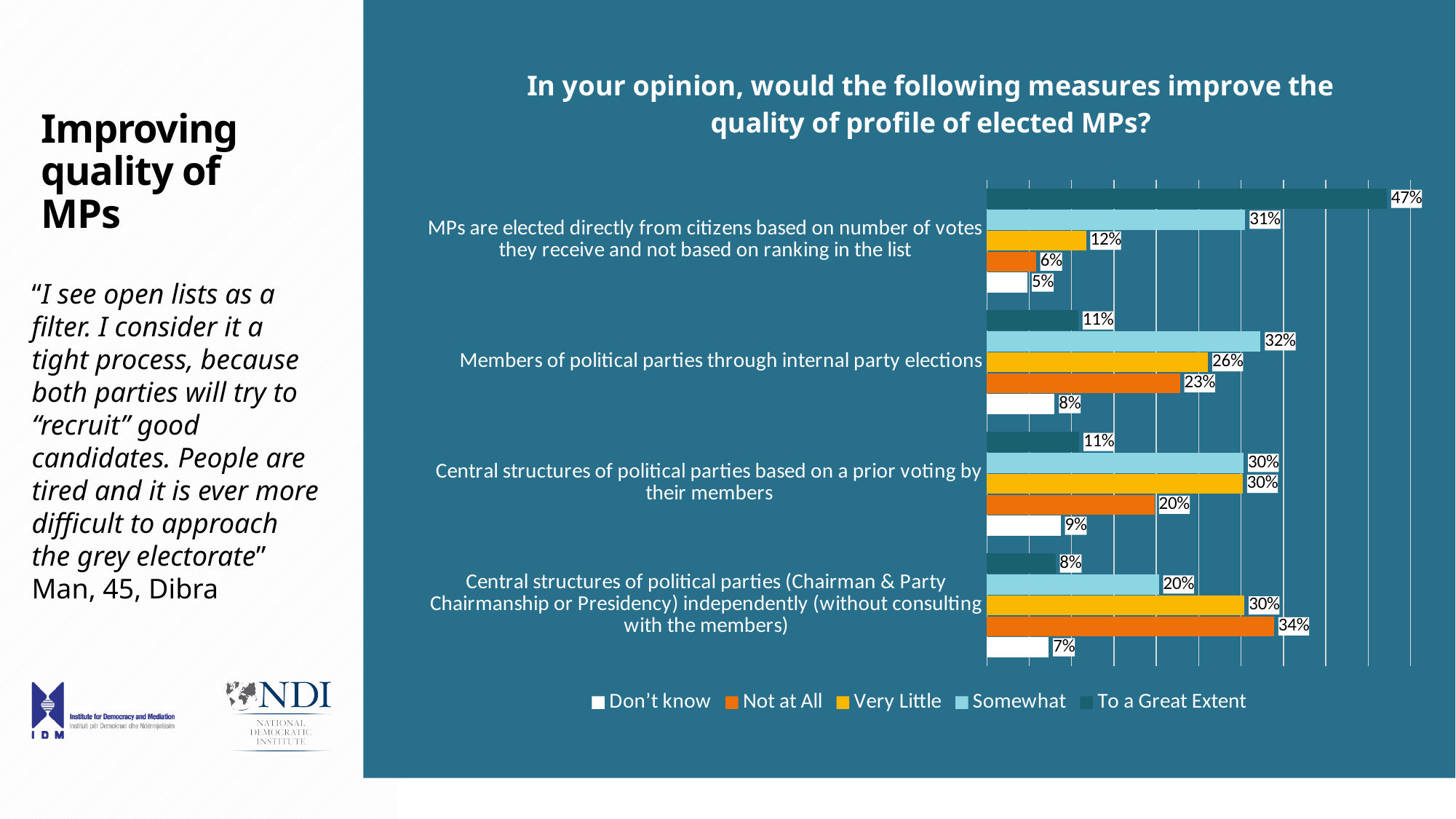
How many series does the legend list? 5 What is the 'Not at All' value for 'Central structures of political parties (Chairman & Party Chairmanship or Presidency) independently (without consulting with the members)'? 34% What is the 'Somewhat' value for 'Members of political parties through internal party elections'? 32% Which is larger: the 'Not at All' value for 'Members of political parties through internal party elections' or the 'Not at All' value for 'Central structures of political parties based on a prior voting by their members'? Members of political parties through internal party elections What percentage of respondents said 'To a Great Extent' for the measure 'MPs are elected directly from citizens based on number of votes they receive and not based on ranking in the list'? 47% How many measures (categories) are shown in the chart? 4 Which legend entry is shown in orange? Not at All What type of chart is shown on the slide? Bar chart What is the difference between the 'To a Great Extent' value for 'MPs are elected directly from citizens...' and the 'To a Great Extent' value for 'Members of political parties through internal party elections'? 36% What is the 'Don't know' value for 'Central structures of political parties based on a prior voting by their members'? 9% Which measure has the lowest 'Somewhat' value? Central structures of political parties (Chairman & Party Chairmanship or Presidency) independently (without consulting with the members) Which measure has the highest 'To a Great Extent' value? MPs are elected directly from citizens based on number of votes they receive and not based on ranking in the list